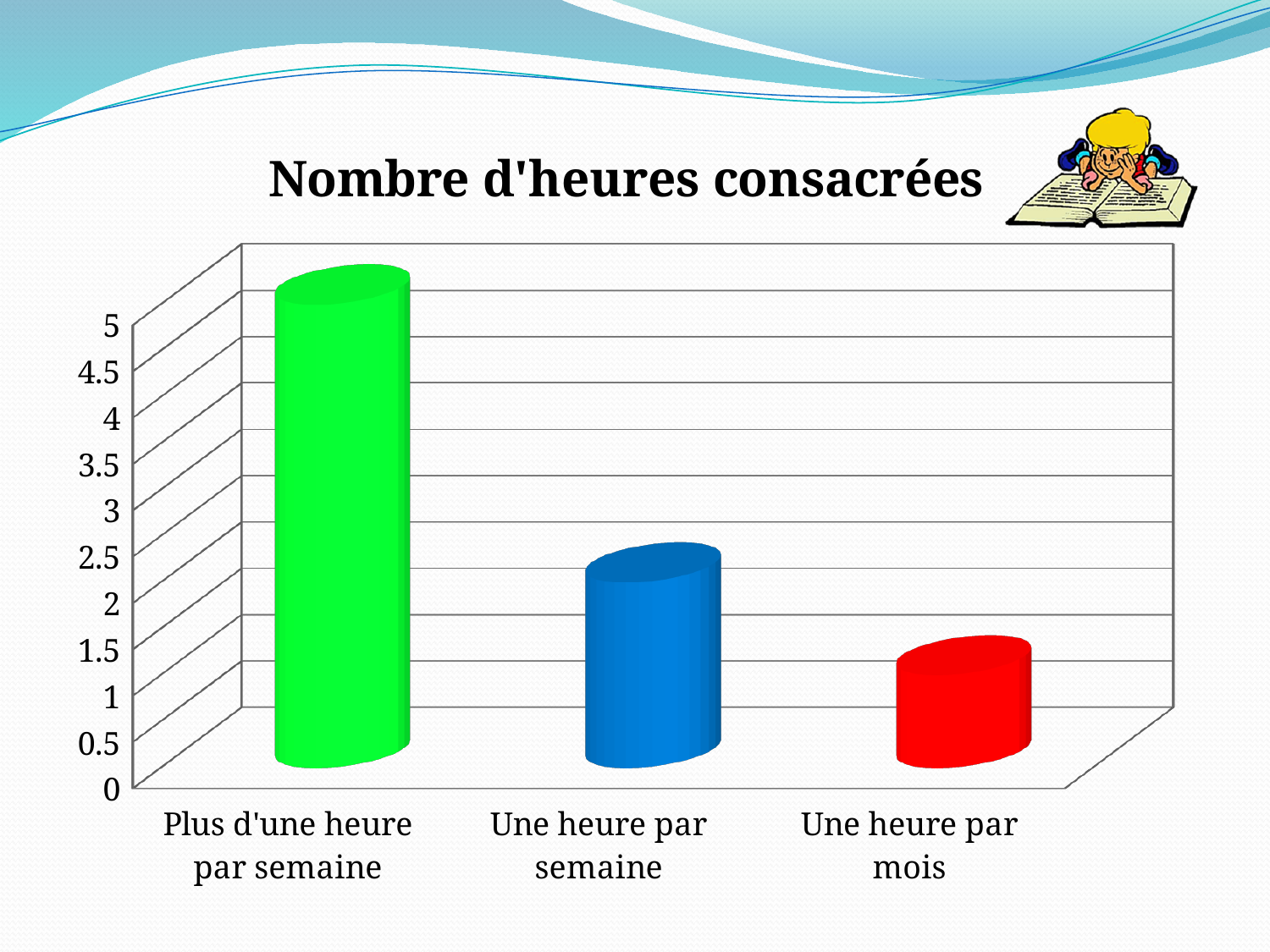
Which category has the highest value? Plus d'une heure par semaine What colour is the bar for "Une heure par mois"? red Which is larger, the value for "Une heure par semaine" or the value for "Une heure par mois"? Une heure par semaine Which category has the lowest value? Une heure par mois Is the value for "Plus d'une heure par semaine" greater or less than 4? greater Is the value for "Une heure par mois" greater or less than 2? less Is the value for "Une heure par semaine" greater or less than 1? greater How many categories are shown on the x axis of the chart? 3 Do the values rise or fall from left to right along the x axis? fall What kind of chart is shown on the slide? bar chart What is the title of the chart? Nombre d'heures consacrées